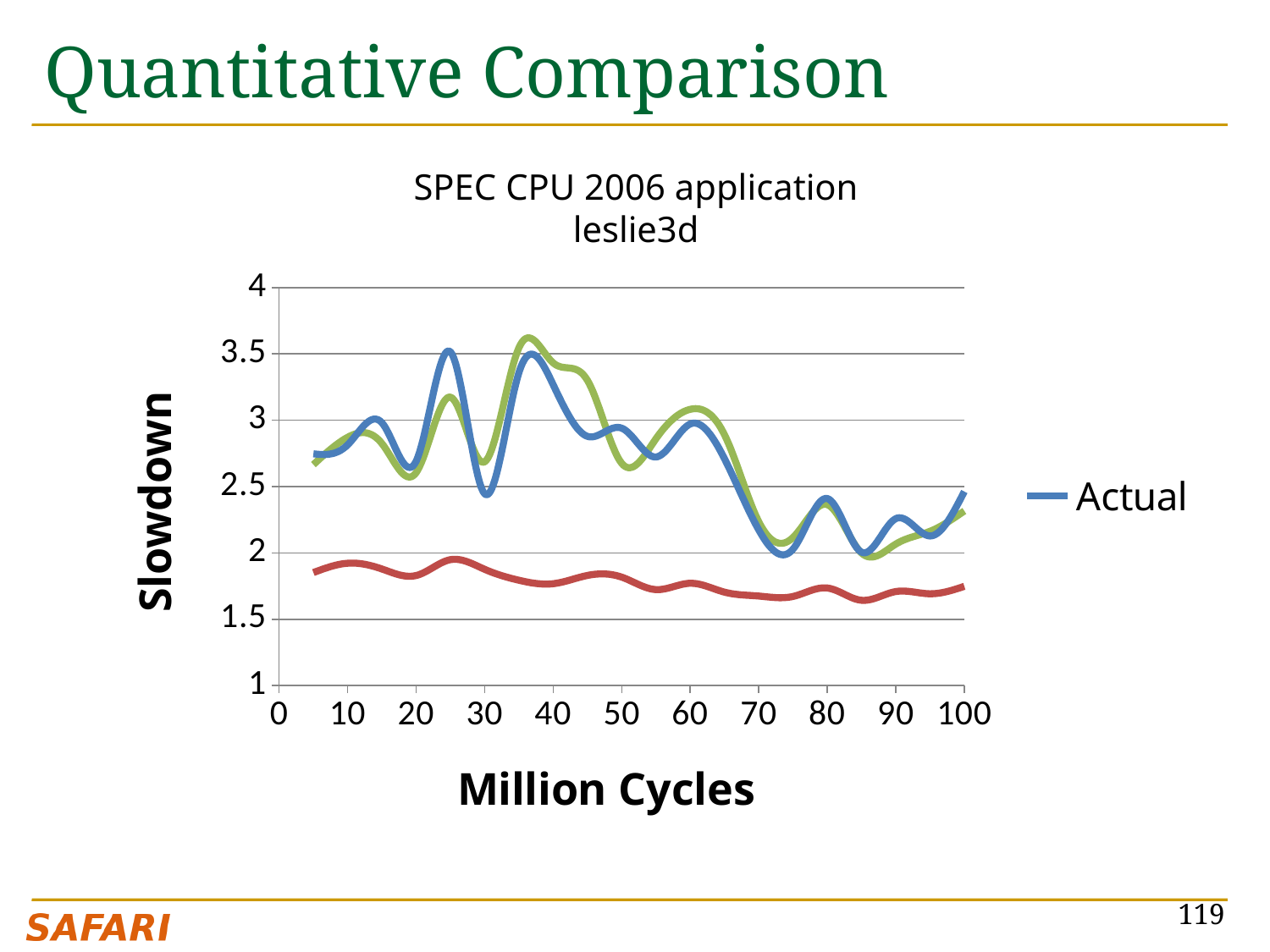
What kind of chart is shown on the slide? line chart Is the Actual slowdown at 10 million cycles greater or less than 2.5? greater Does the Actual slowdown rise or fall between 60 and 75 million cycles? fall At 50 million cycles, which is larger: the Actual slowdown or the red line's slowdown? Actual How many series does the chart's legend list? 1 Which of the three plotted lines stays lowest across the whole x axis? the red line Is the Actual slowdown at 70 million cycles greater or less than 2.5? less Is the red line's slowdown at 50 million cycles greater or less than 2? less What is the title of the chart? SPEC CPU 2006 application leslie3d What is the name of the series listed in the legend? Actual